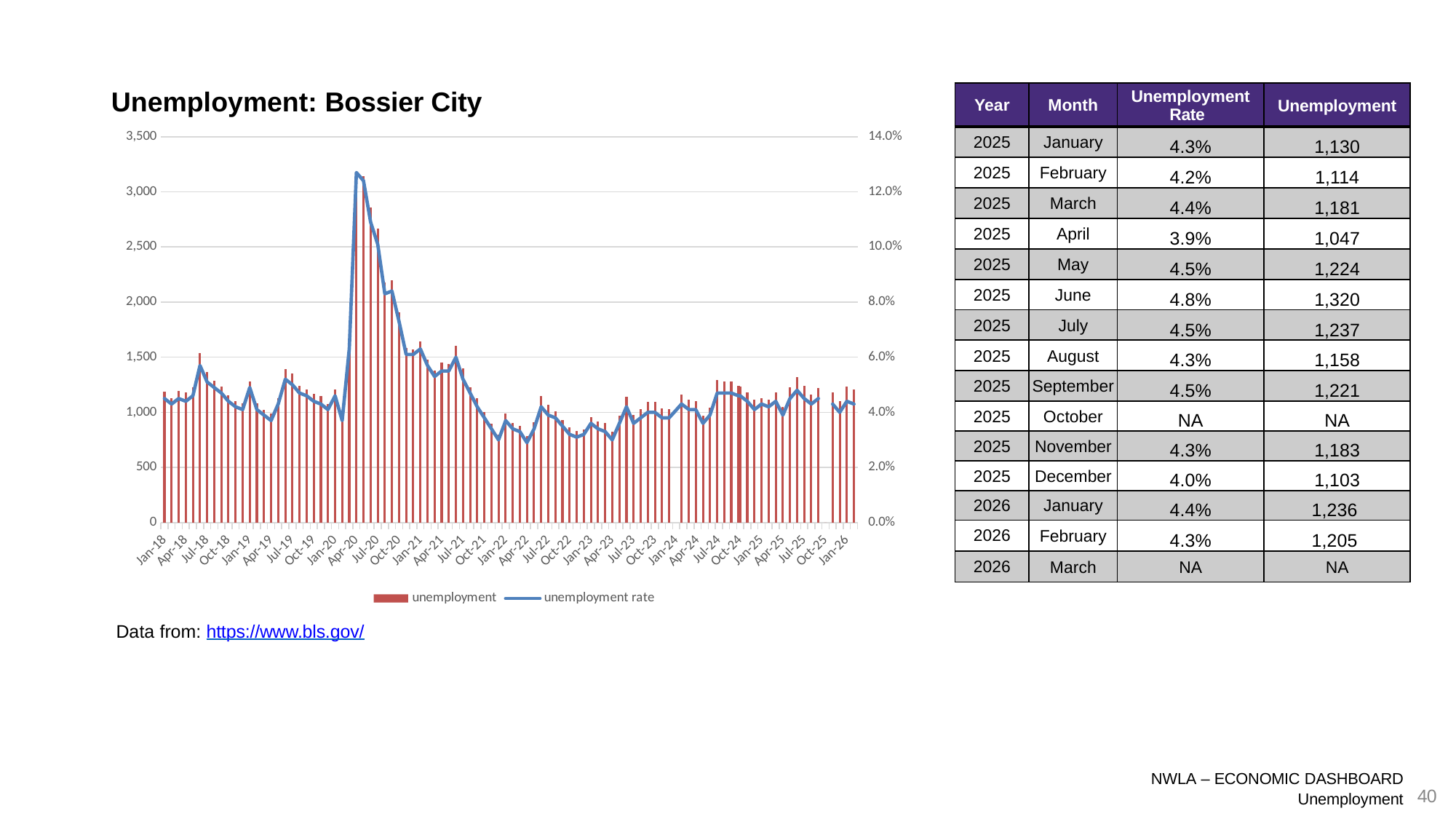
Is the unemployment bar for Jan-18 greater or less than 1,000? greater According to the table on the slide, what was the unemployment count in February 2026? 1,205 What kind of chart is shown on the slide? A combined bar and line chart How many series does the chart legend list? 2 What is the title of the chart? Unemployment: Bossier City Is the unemployment bar for Apr-20 greater or less than 3,000? greater Is the unemployment rate line at its Apr-20 peak greater or less than 12.0%? greater According to the table on the slide, what was the unemployment rate in June 2025? 4.8% Which series is drawn as a line in the chart? unemployment rate Does the unemployment rate rise or fall between Apr-20 and Jan-22? fall